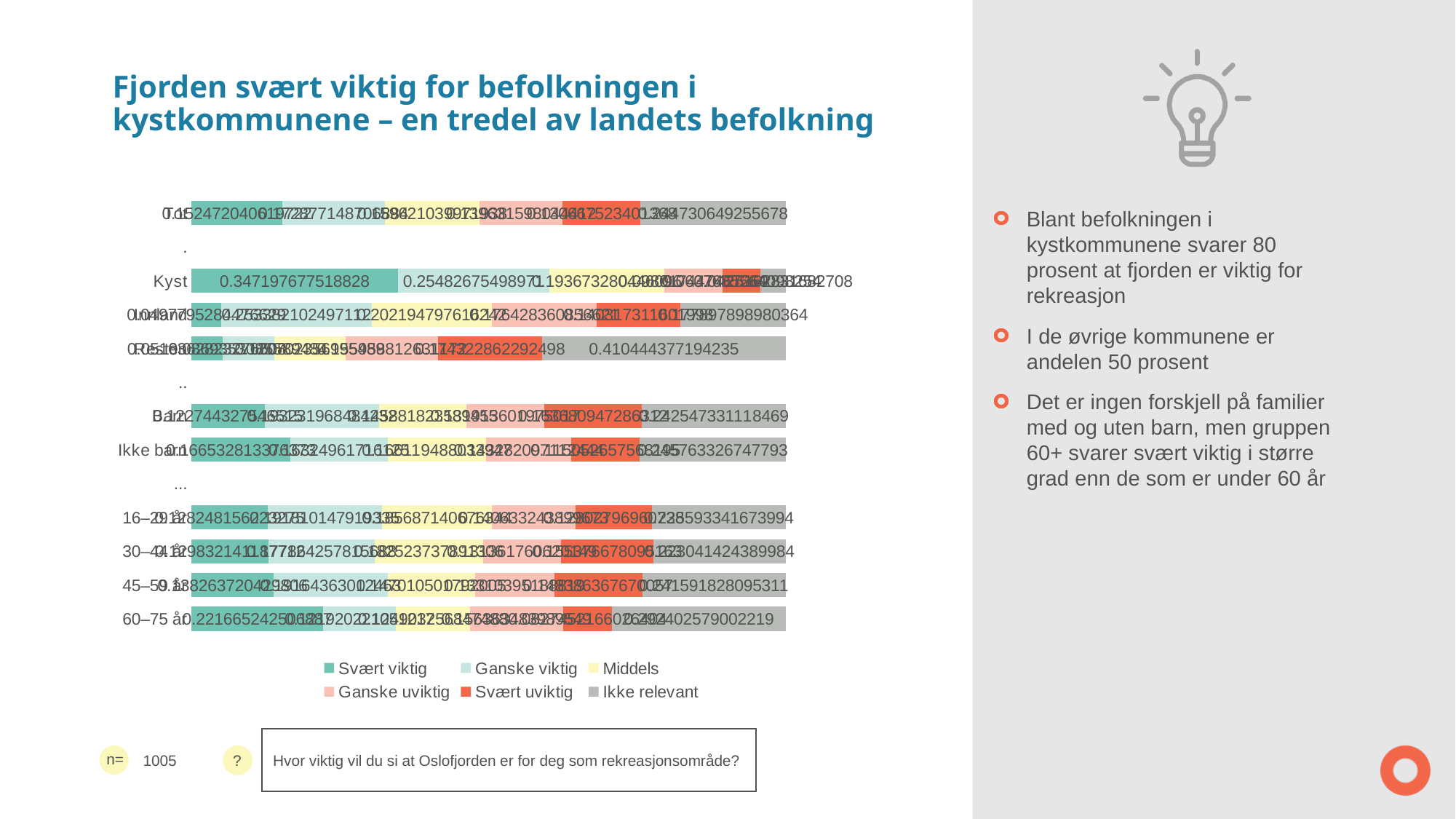
What is the 'Svært viktig' value for Kyst? 0.347197677518828 How many series does the chart legend list? 6 Which age group has the larger 'Svært viktig' share: 16–29 år or 60–75 år? 60–75 år What kind of chart is shown on the slide? Stacked bar chart Which has the larger 'Ikke relevant' share: Kyst or the bar directly below it? The bar below Kyst Which colour represents 'Ikke relevant' in the chart? Grey Which has the larger 'Svært viktig' share: Kyst or the bar directly below it? Kyst What are the legend entries of the chart? Svært viktig, Ganske viktig, Middels, Ganske uviktig, Svært uviktig, Ikke relevant